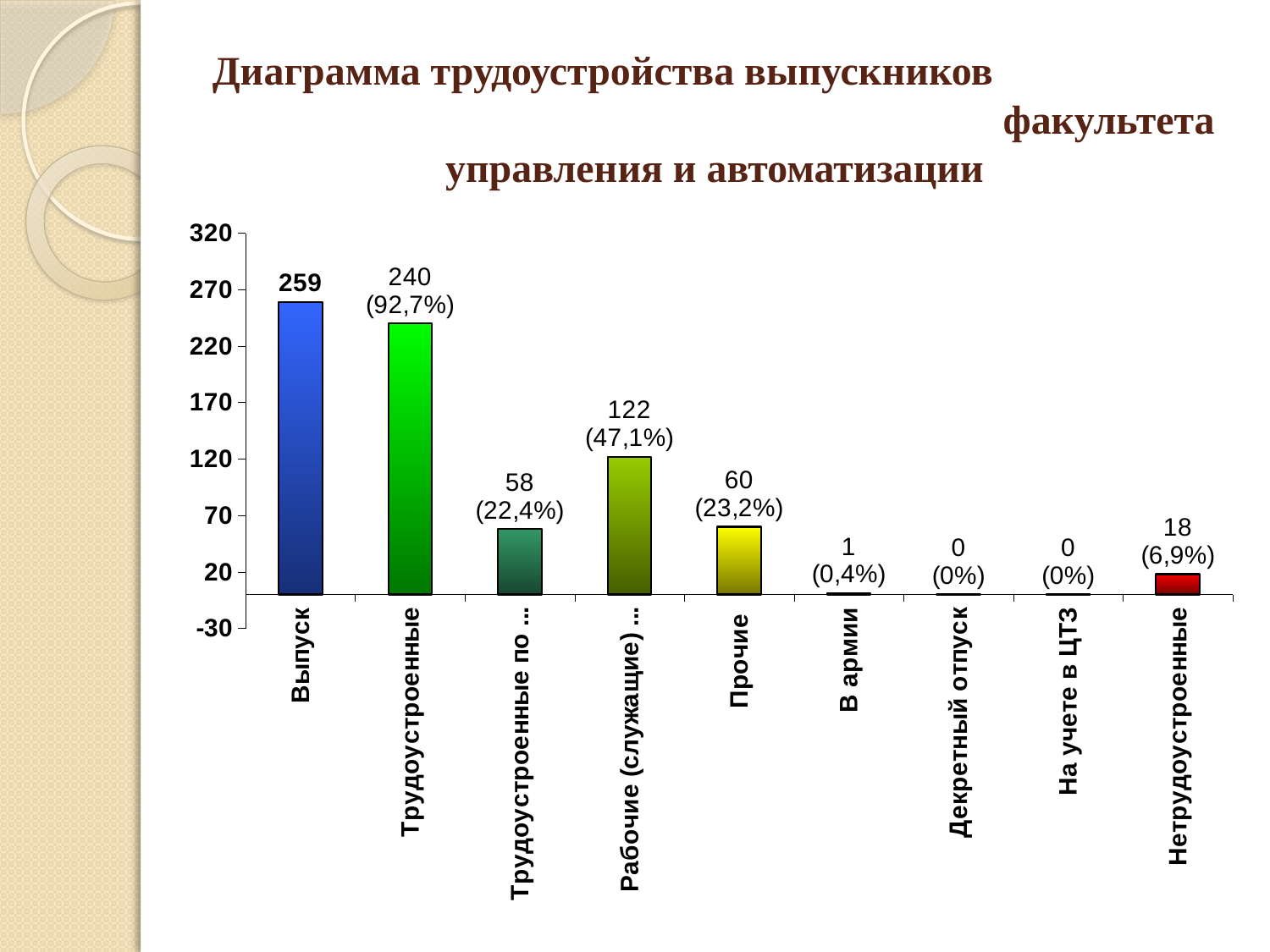
What is the value for Нетрудоустроенные? 18 What percentage is shown for Трудоустроенные? 92,7% What is the difference between the values for Выпуск and Трудоустроенные? 19 What is the value for Трудоустроенные? 240 Which is larger, the value for Прочие or the value for Нетрудоустроенные? Прочие What is the value for В армии? 1 What is the value for Декретный отпуск? 0 How many categories are shown on the x axis? 9 Which category has the highest value? Выпуск What is the value for Выпуск? 259 What type of chart is shown on the slide? bar chart What percentage is shown for Прочие? 23,2%